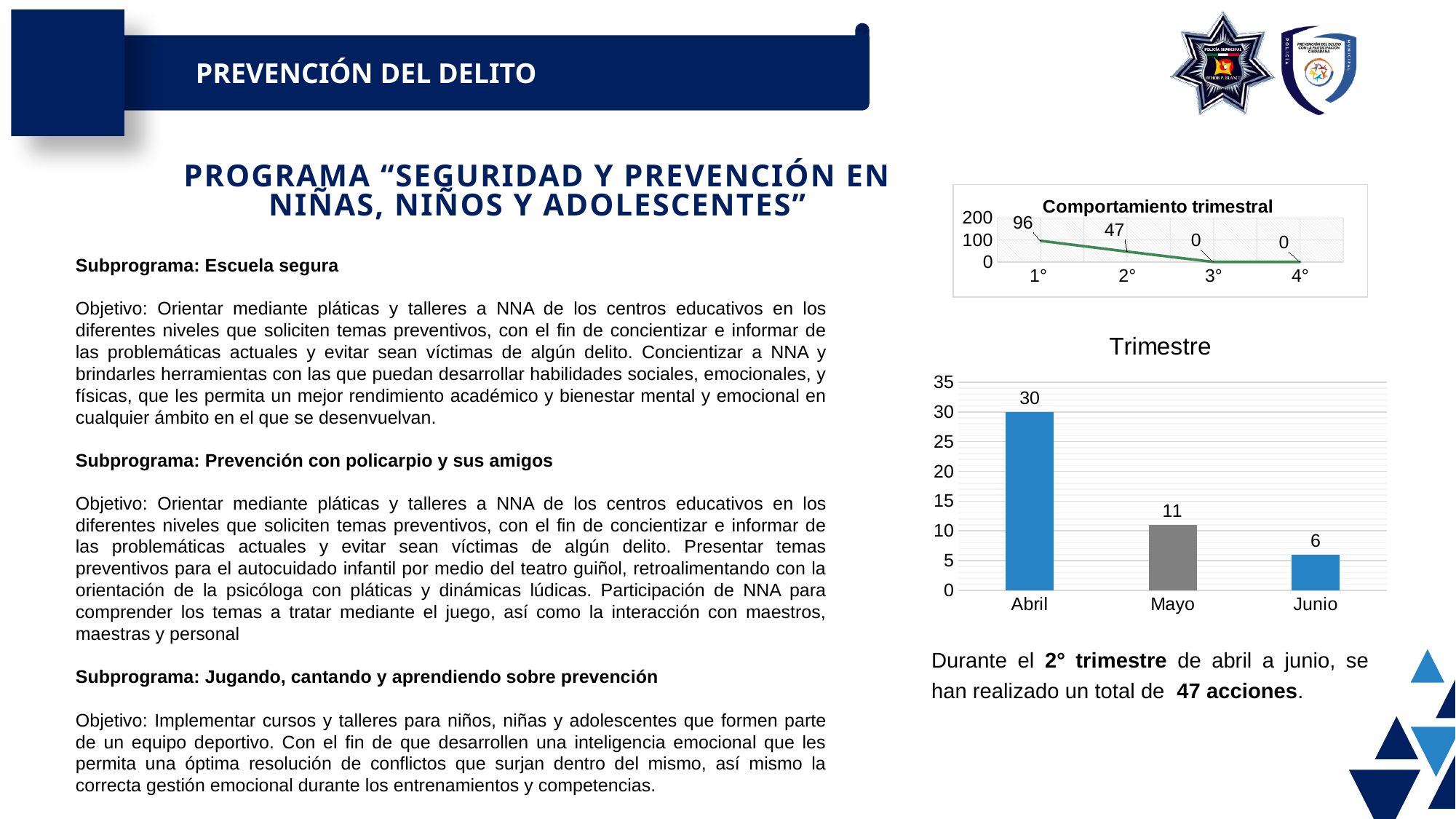
In the 'Comportamiento trimestral' chart, which category has the highest value? 1° In the 'Trimestre' chart, what is the value for Abril? 30 In the 'Comportamiento trimestral' chart, what is the value for 2°? 47 In the 'Trimestre' chart, which month has the lowest value? Junio What kind of chart is 'Comportamiento trimestral'? line chart What kind of chart is the 'Trimestre' chart? bar chart In the 'Comportamiento trimestral' chart, what is the difference between the values for 1° and 2°? 49 In the 'Comportamiento trimestral' chart, what is the value for 1°? 96 In the 'Trimestre' chart, what is the value for Mayo? 11 In the 'Comportamiento trimestral' chart, do the values rise or fall from 1° to 4°? fall In the 'Trimestre' chart, what is the difference between the values for Abril and Junio? 24 In the 'Trimestre' chart, how many categories are shown on the x axis? 3